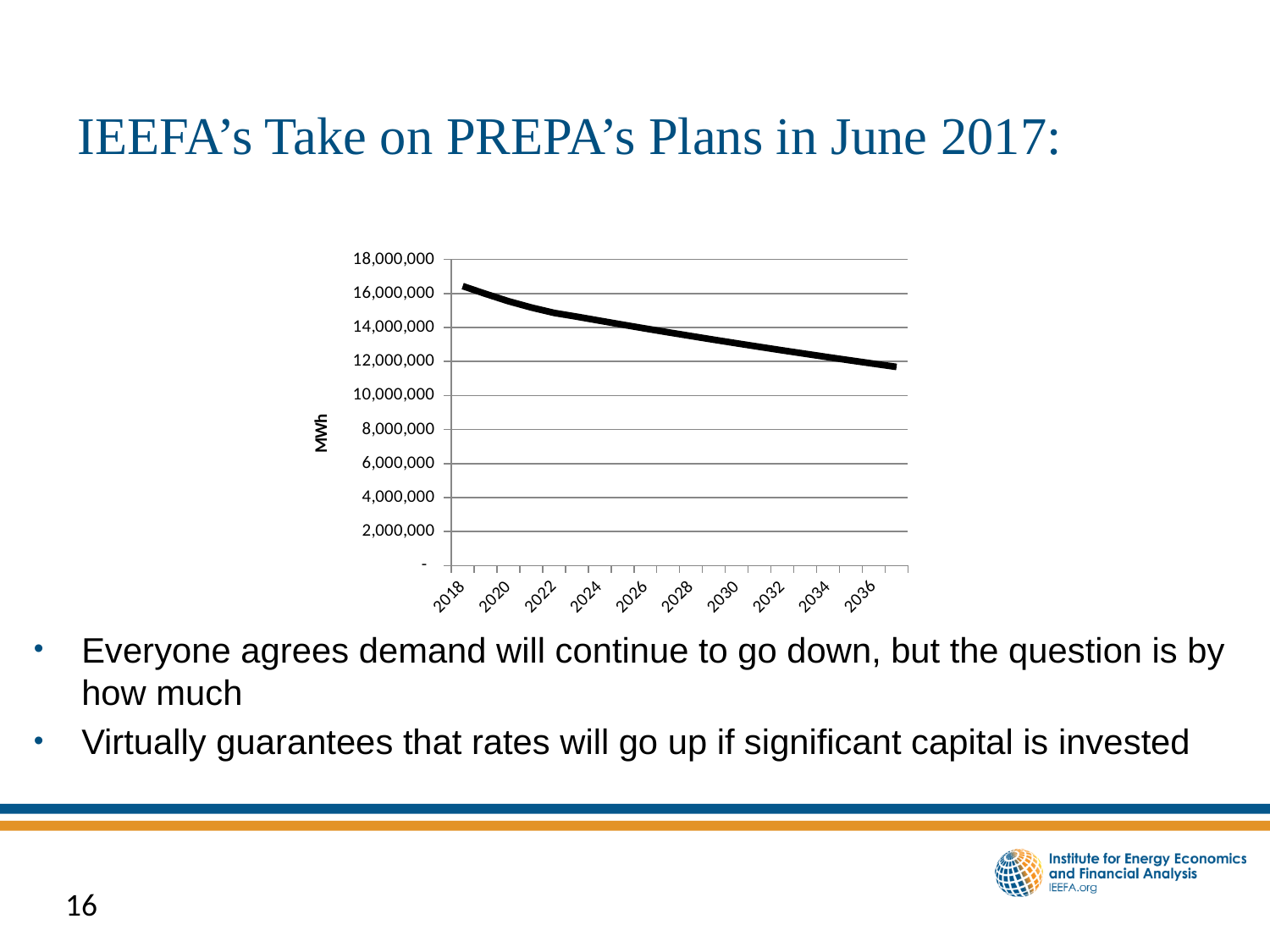
Is the value for 2018 greater or less than 14,000,000? greater Do the values on the chart rise or fall from 2018 to 2036? fall What kind of chart is shown on the slide? line chart Which is larger, the value for 2020 or the value for 2030? 2020 What unit is shown on the vertical axis label? MWh Is the value for 2022 greater or less than 14,000,000? greater Which year has the highest value on the chart? 2018 Is the value for 2030 greater or less than 14,000,000? less How many year labels are shown along the x axis? 10 What is the highest tick value shown on the vertical axis? 18,000,000